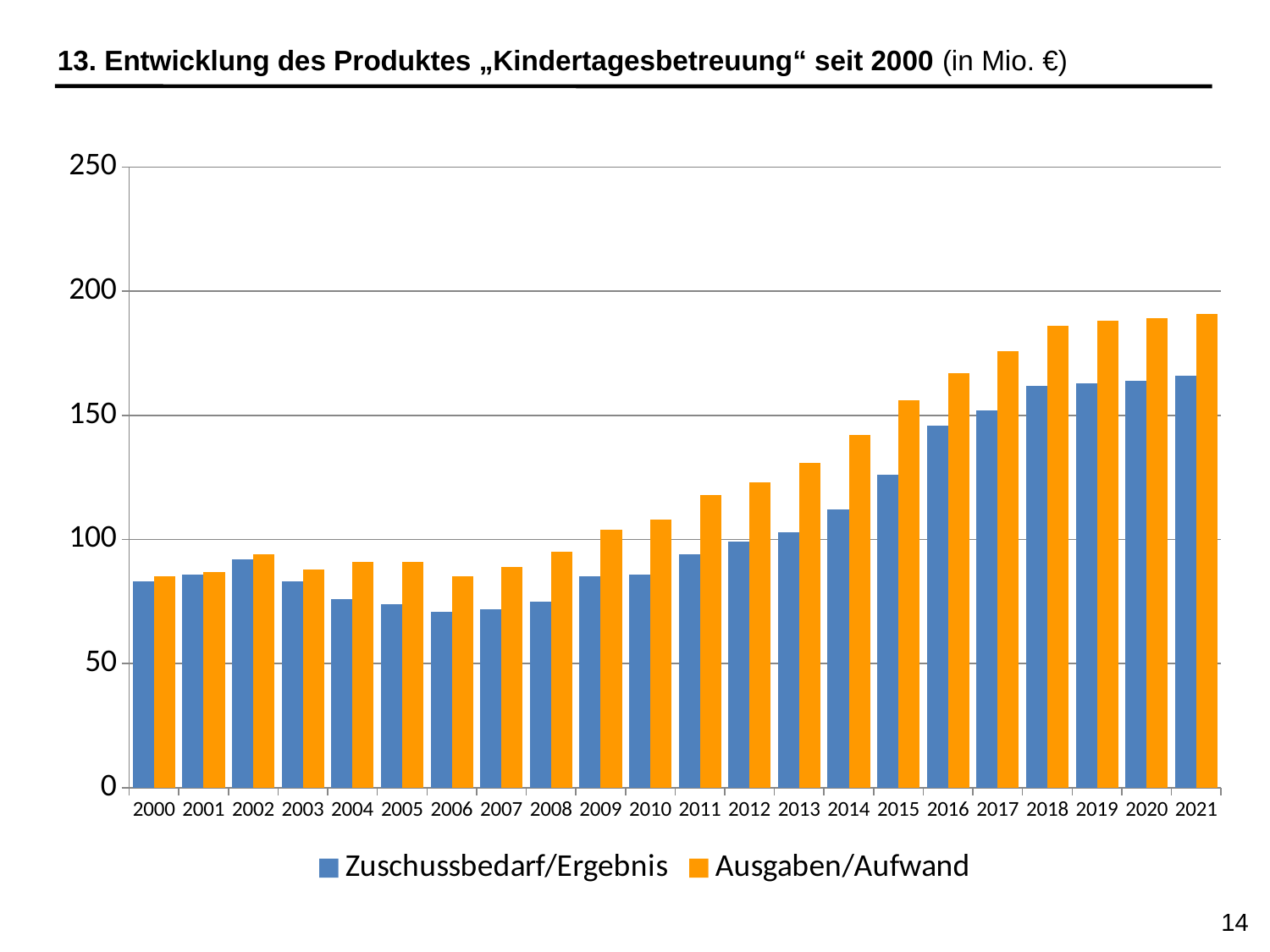
How many series does the legend list? 2 Is the value for Zuschussbedarf/Ergebnis in 2014 greater or less than 100? greater How many years are shown on the x axis? 22 In 2021, which is larger: Zuschussbedarf/Ergebnis or Ausgaben/Aufwand? Ausgaben/Aufwand What kind of chart is shown on the slide? bar chart Is the value for Ausgaben/Aufwand in 2013 greater or less than 150? less Is the value for Zuschussbedarf/Ergebnis in 2006 greater or less than 100? less Do the values for Ausgaben/Aufwand rise or fall from 2009 to 2021? rise For Zuschussbedarf/Ergebnis, which is larger: the value in 2002 or the value in 2006? 2002 Which year has the highest value for Ausgaben/Aufwand? 2021 Which colour represents Ausgaben/Aufwand in the legend? orange